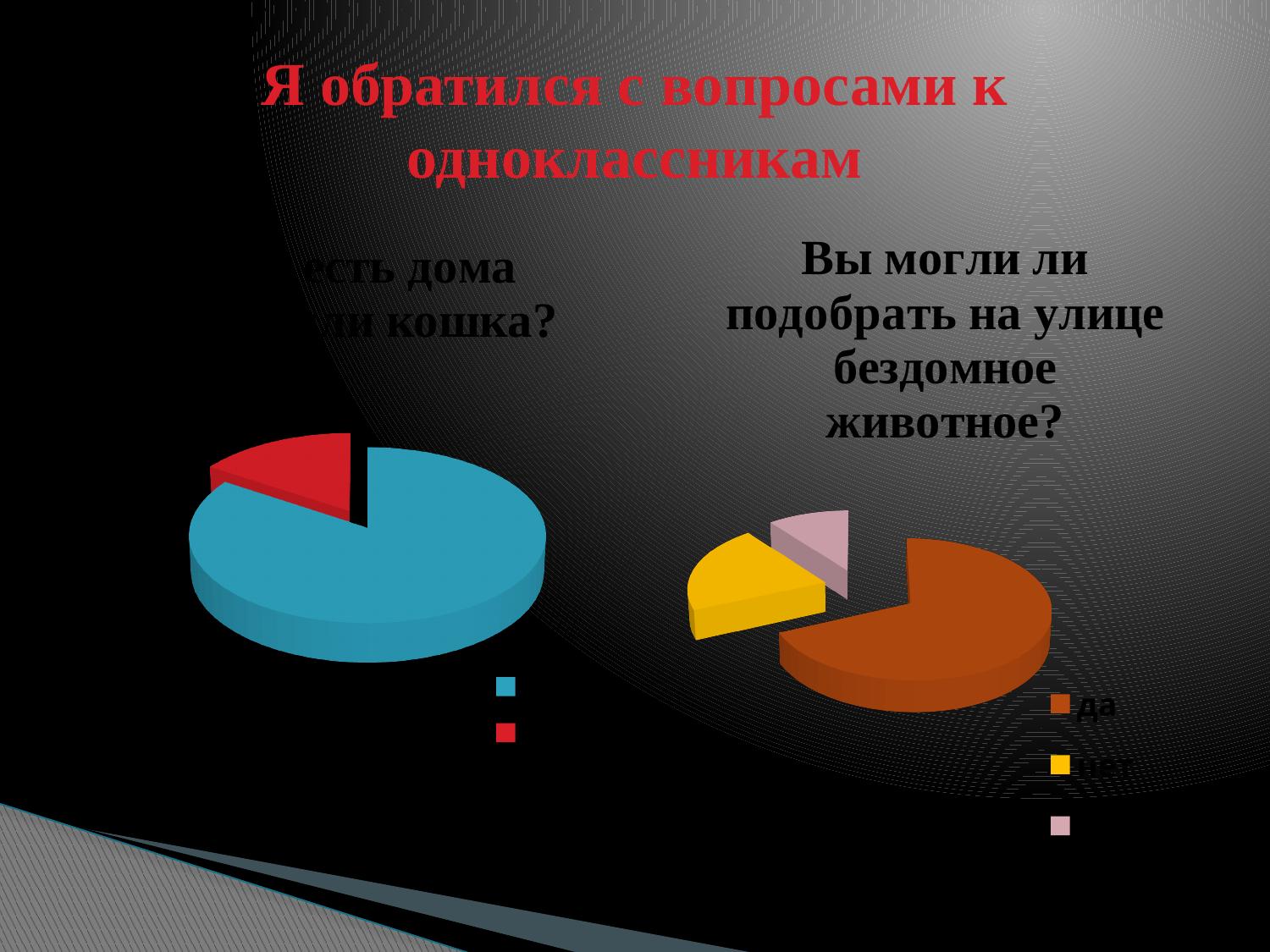
How many slices does the pie chart on the left of the slide have? 2 In the pie chart on the left of the slide, which colour slice is the smallest? red In the pie chart titled "Вы могли ли подобрать на улице бездомное животное?", which slice is larger, the yellow one or the pink one? the yellow one In the pie chart titled "Вы могли ли подобрать на улице бездомное животное?", which colour slice is the smallest? pink How many entries does the legend of the pie chart titled "Вы могли ли подобрать на улице бездомное животное?" list? 3 In the pie chart titled "Вы могли ли подобрать на улице бездомное животное?", which category has the largest slice? да What kind of chart is the chart on the left of the slide? pie chart How many slices does the pie chart titled "Вы могли ли подобрать на улице бездомное животное?" have? 3 In the pie chart titled "Вы могли ли подобрать на улице бездомное животное?", which slice is larger, "да" or "нет"? да In the pie chart on the left of the slide, which slice is larger, the blue one or the red one? the blue one What kind of chart is the chart titled "Вы могли ли подобрать на улице бездомное животное?"? pie chart In the pie chart titled "Вы могли ли подобрать на улице бездомное животное?", what colour is the slice for "да"? orange